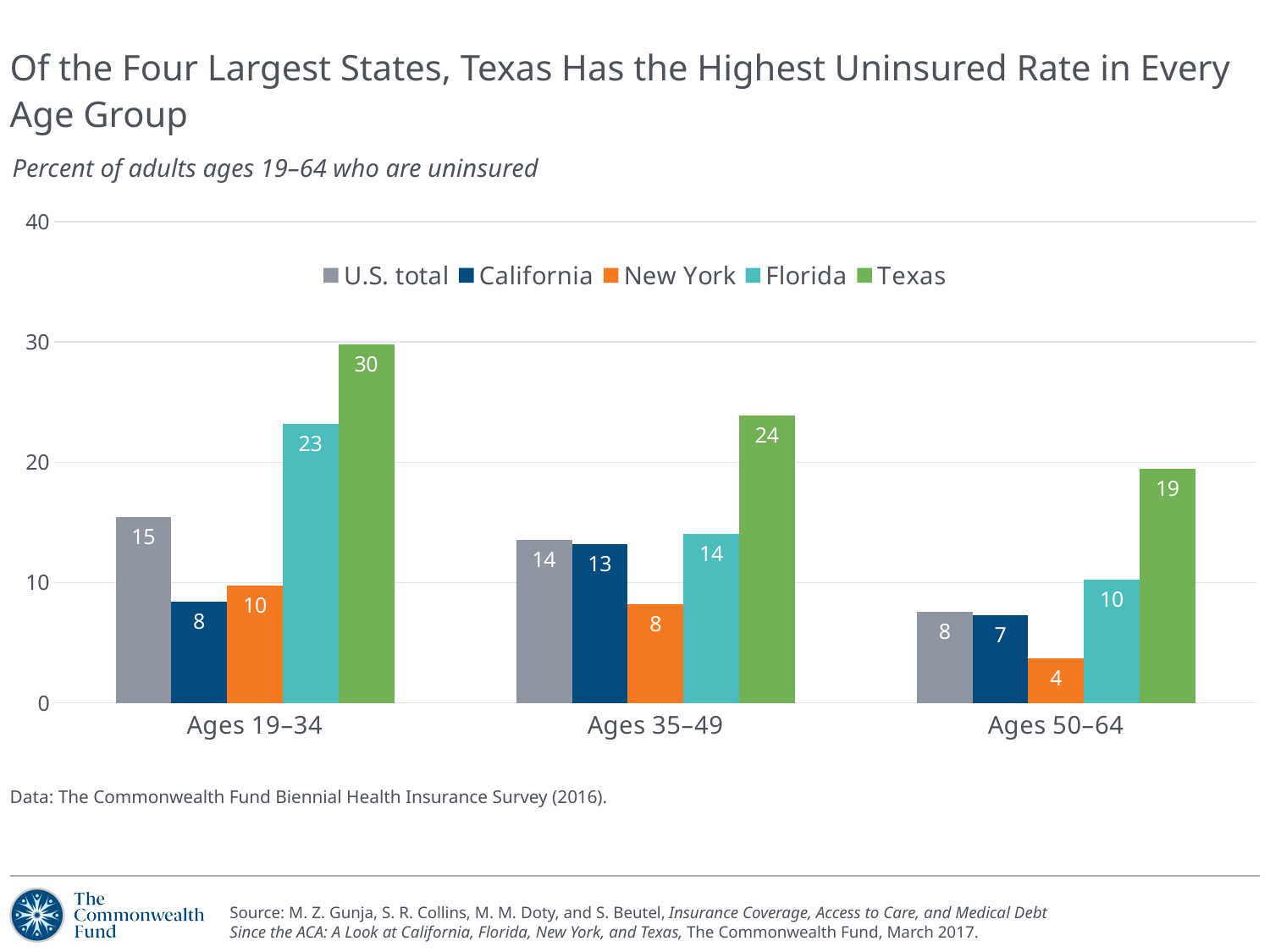
What colour are the bars for Texas? Green Which series has the highest uninsured rate in the Ages 19–34 group? Texas What is the uninsured rate for Texas among adults ages 19–34? 30 How many series does the legend list? 5 Which series has the lowest uninsured rate in the Ages 50–64 group? New York What is the uninsured rate for New York among adults ages 50–64? 4 What is the uninsured rate for Florida among adults ages 35–49? 14 Which is larger for ages 35–49: the uninsured rate for California or for New York? California What kind of chart is shown on the slide? Bar chart Do the Texas uninsured rates rise or fall as age group increases along the x axis? Fall What is the difference between the Texas and California uninsured rates for ages 19–34? 22 How many age groups are shown on the x axis? 3